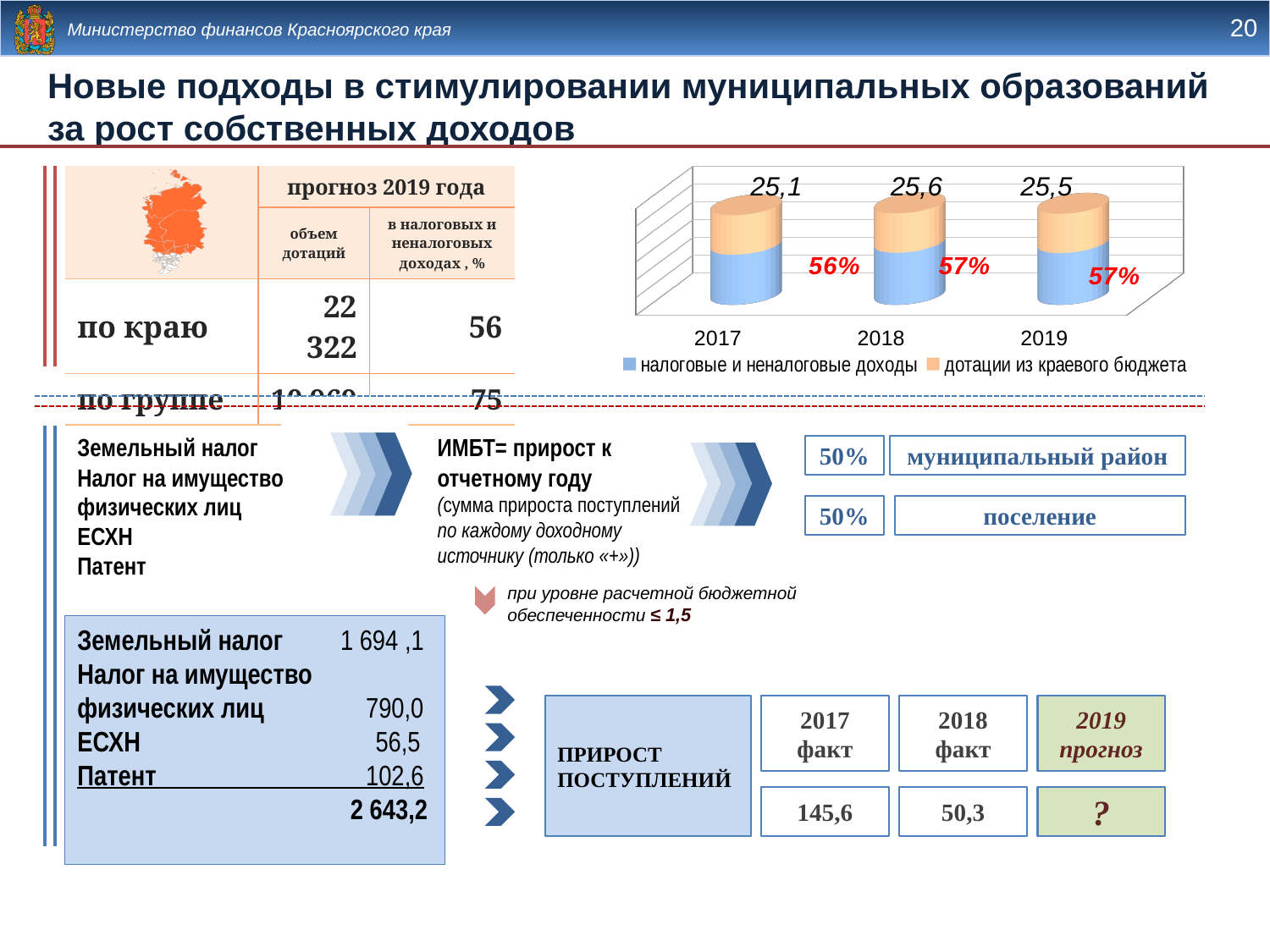
What total value is shown above the bar for 2019? 25,5 Which year has the highest total value on the chart? 2018 What percentage label is shown in red for 2019? 57% What total value is shown above the bar for 2018? 25,6 What kind of chart is shown on the slide? Stacked bar chart What percentage label is shown in red for 2017? 56% Which year has the lowest total value on the chart? 2017 Which is larger, the total value for 2017 or for 2019? 2019 What is the difference between the total values for 2018 and 2017? 0,5 How many years are shown on the x axis of the chart? 3 What total value is shown above the bar for 2017? 25,1 How many series does the chart legend list? 2